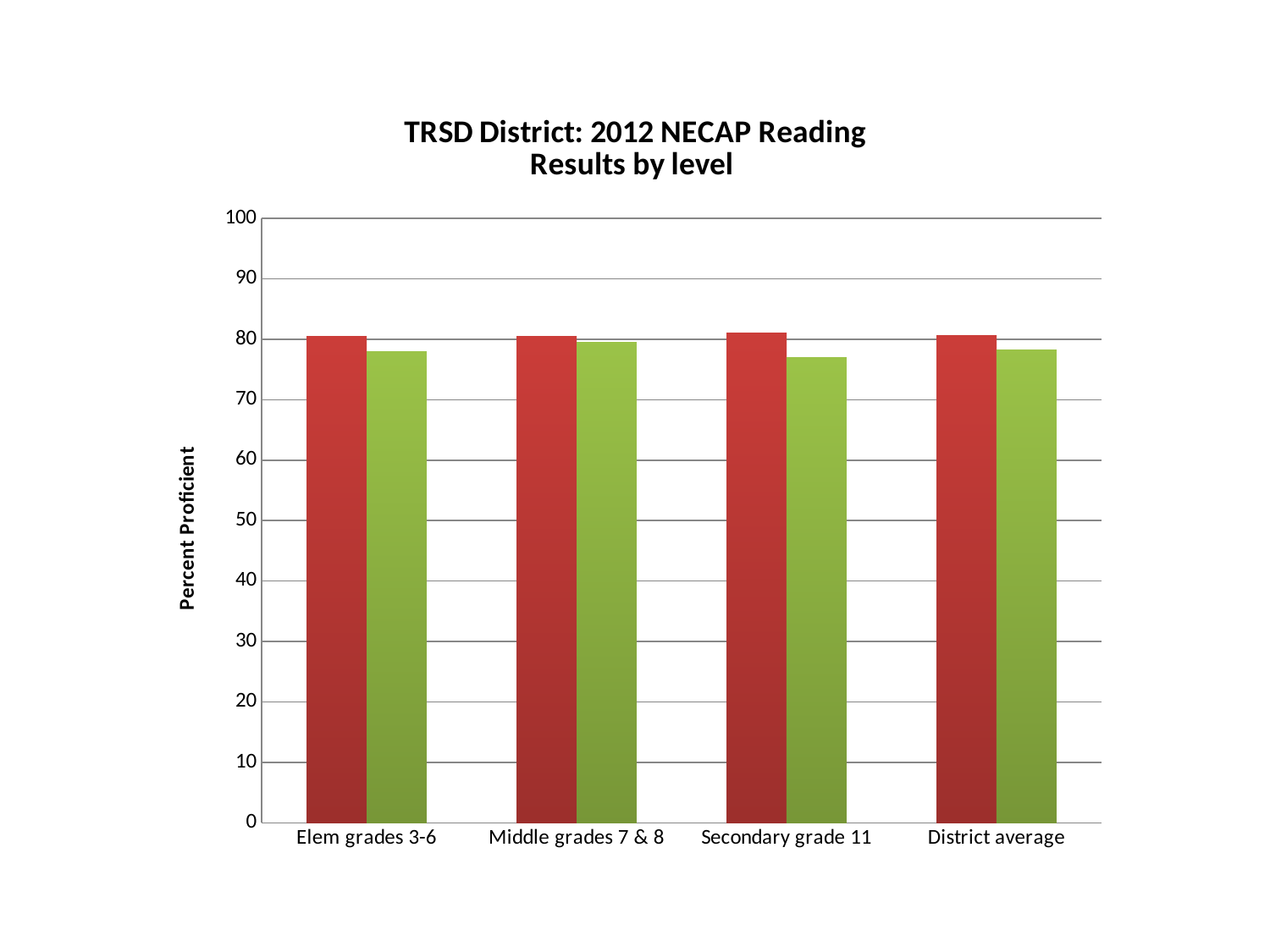
Is the green bar for Elem grades 3-6 greater or less than 80? less Is the red bar for Secondary grade 11 greater or less than 70? greater What is the label on the vertical axis of the chart? Percent Proficient Is the green bar for District average greater or less than 70? greater How many categories are shown along the x axis of the chart? 4 What is the title of the chart? TRSD District: 2012 NECAP Reading Results by level For Elem grades 3-6, which bar is taller, the red bar or the green bar? the red bar For Secondary grade 11, which bar is taller, the red bar or the green bar? the red bar What kind of chart is shown on the slide? bar chart